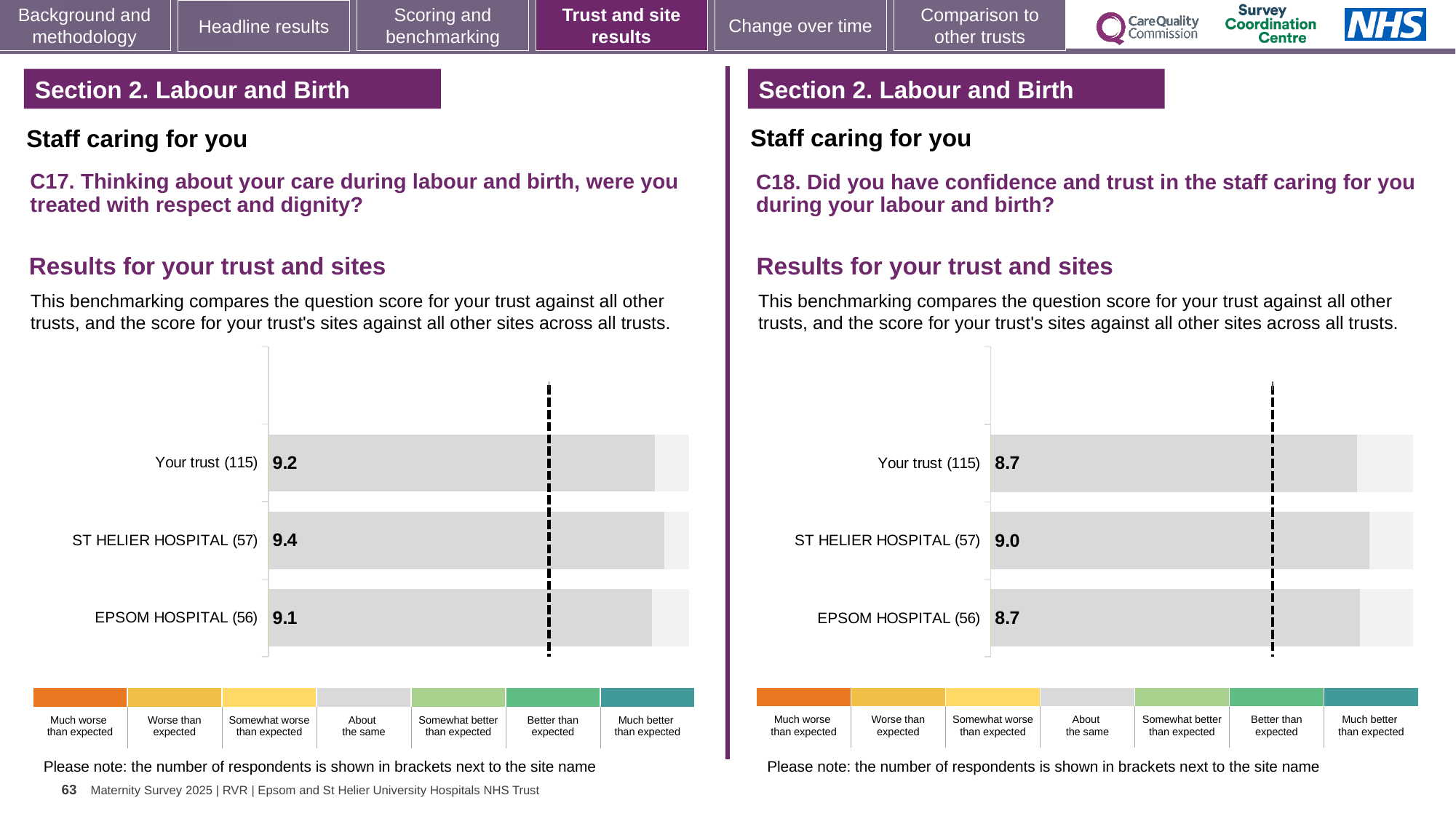
In the C17 chart on the left, what is the difference between the scores for ST HELIER HOSPITAL (57) and EPSOM HOSPITAL (56)? 0.3 How many bars are plotted in the C17 chart on the left? 3 In the C18 chart on the right, which site or trust has the highest score? ST HELIER HOSPITAL (57) In the C17 chart on the left, what is the score for Your trust (115)? 9.2 In the C18 chart on the right, what is the score for EPSOM HOSPITAL (56)? 8.7 In the C17 chart on the left, which site or trust has the highest score? ST HELIER HOSPITAL (57) In the C18 chart on the right, what is the score for ST HELIER HOSPITAL (57)? 9.0 In the C18 chart on the right, what is the difference between the scores for ST HELIER HOSPITAL (57) and Your trust (115)? 0.3 In the C17 chart on the left, what is the score for ST HELIER HOSPITAL (57)? 9.4 In the C17 chart on the left, which site or trust has the lowest score? EPSOM HOSPITAL (56) What type of chart is used in the C18 chart on the right? Bar chart Is the score for Your trust (115) larger in the C17 chart on the left or the C18 chart on the right? C17 chart on the left